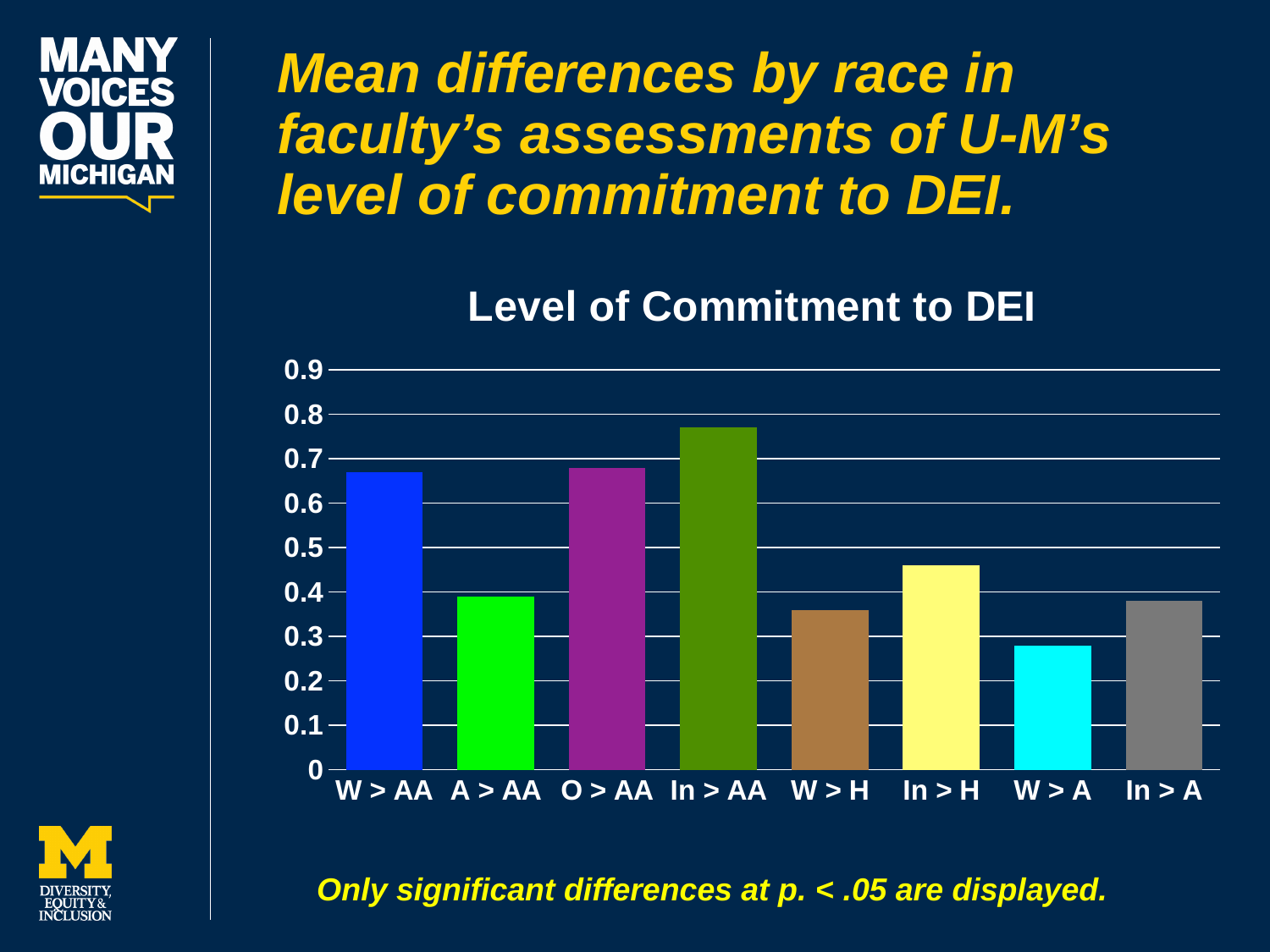
What is the title of the chart? Level of Commitment to DEI Which is larger, the value for In > H or the value for W > A? In > H How many categories are shown on the x axis of the chart? 8 Which category has the highest value in the chart? In > AA What colour is the bar for In > AA? green Is the value for W > A greater or less than 0.3? less Is the value for W > AA greater or less than 0.6? greater Is the value for A > AA greater or less than 0.5? less What type of chart is shown on the slide? bar chart Which is larger, the value for In > AA or the value for W > H? In > AA Which category has the lowest value in the chart? W > A